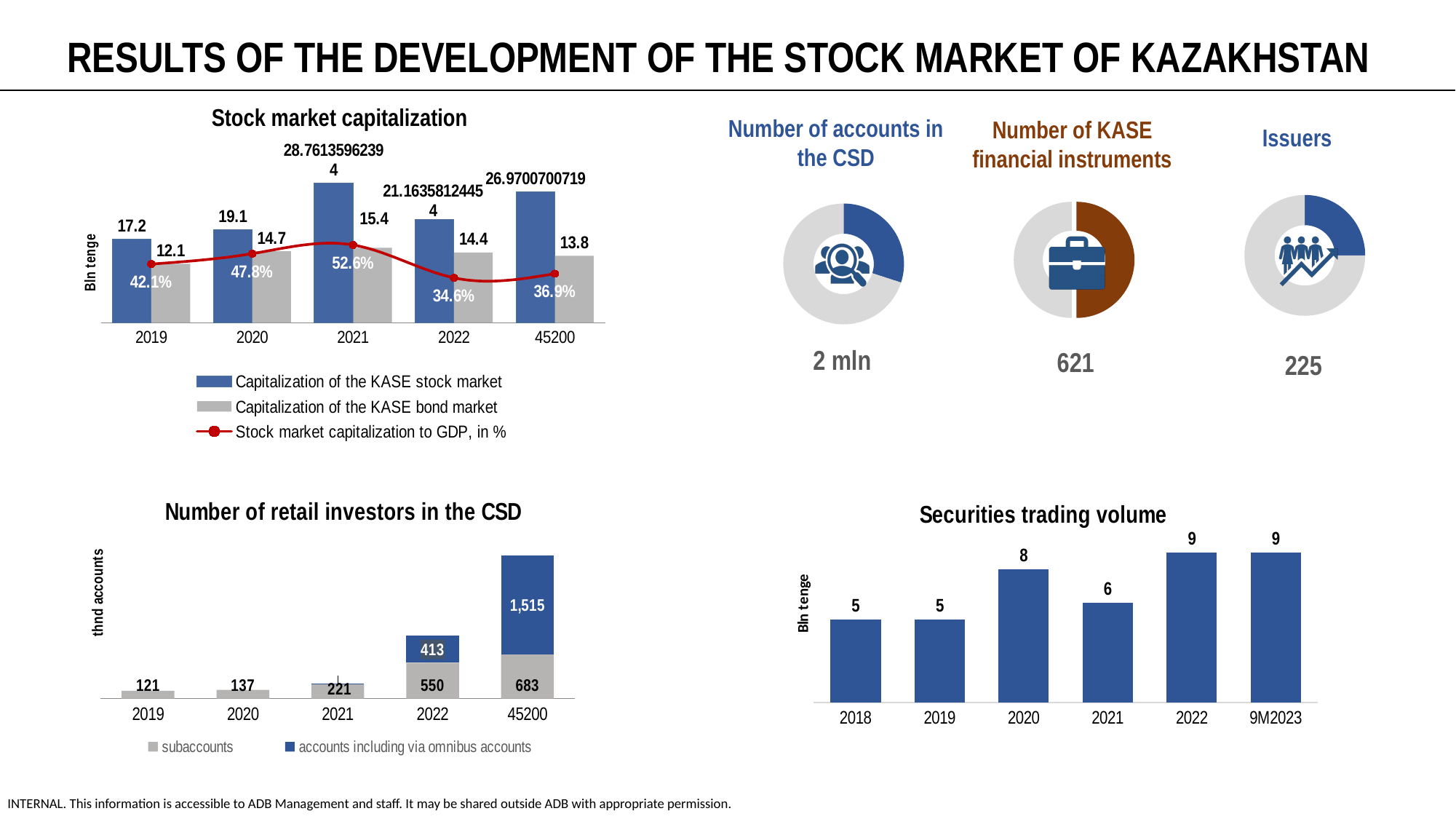
What kind of chart is the 'Securities trading volume' chart? Bar chart In the 'Securities trading volume' chart, what is the value for 2020? 8 In the 'Stock market capitalization' chart, what is the capitalization of the KASE bond market in 2021? 15.4 In the 'Stock market capitalization' chart, which year has the highest stock market capitalization to GDP? 2021 In the 'Number of retail investors in the CSD' chart, what is the value for subaccounts in 2022? 550 How many series does the legend of the 'Stock market capitalization' chart list? 3 How many categories are shown on the x axis of the 'Securities trading volume' chart? 6 In the 'Stock market capitalization' chart, which year has the lowest capitalization of the KASE bond market? 2019 In the 'Stock market capitalization' chart, what is the difference between the KASE bond market capitalization in 2020 and in 2019? 2.6 In the 'Stock market capitalization' chart, what is the stock market capitalization to GDP in 2021? 52.6% In the 'Number of retail investors in the CSD' chart, what is the total of the stacked bar for 2022? 963 In the 'Number of retail investors in the CSD' chart, what is the value for accounts including via omnibus accounts in the last category (45200)? 1,515